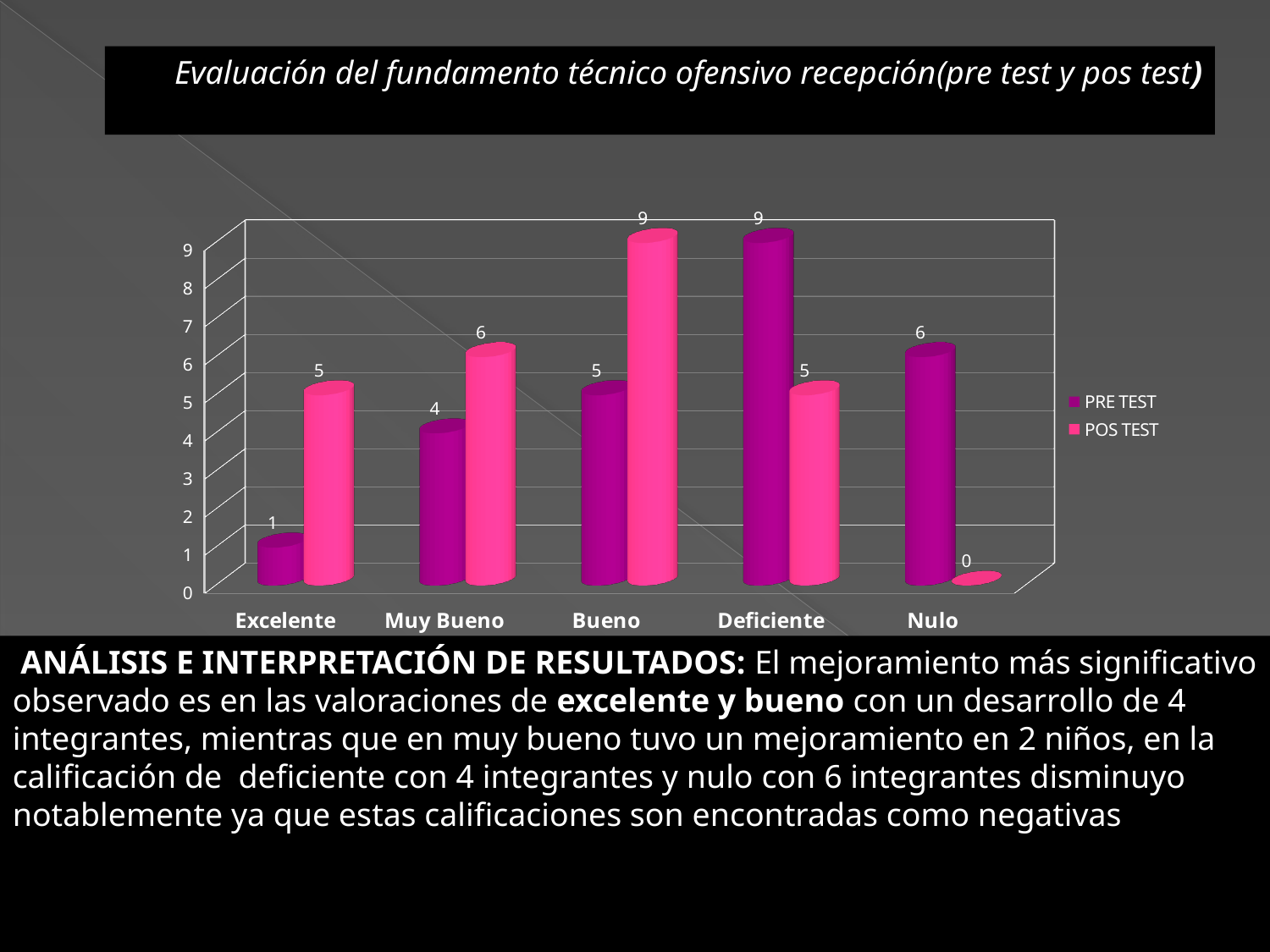
What is the PRE TEST value for Nulo? 6 Which is larger for Deficiente, the PRE TEST value or the POS TEST value? PRE TEST What is the POS TEST value for Muy Bueno? 6 How many categories are shown on the x axis? 5 What is the title of the chart? Evaluación del fundamento técnico ofensivo recepción(pre test y pos test) How many series does the legend list? 2 Which category has the lowest POS TEST value? Nulo Which category has the highest PRE TEST value? Deficiente What is the PRE TEST value for Excelente? 1 What kind of chart is shown on the slide? Bar chart What is the difference between the POS TEST and PRE TEST values for Excelente? 4 What is the POS TEST value for Bueno? 9